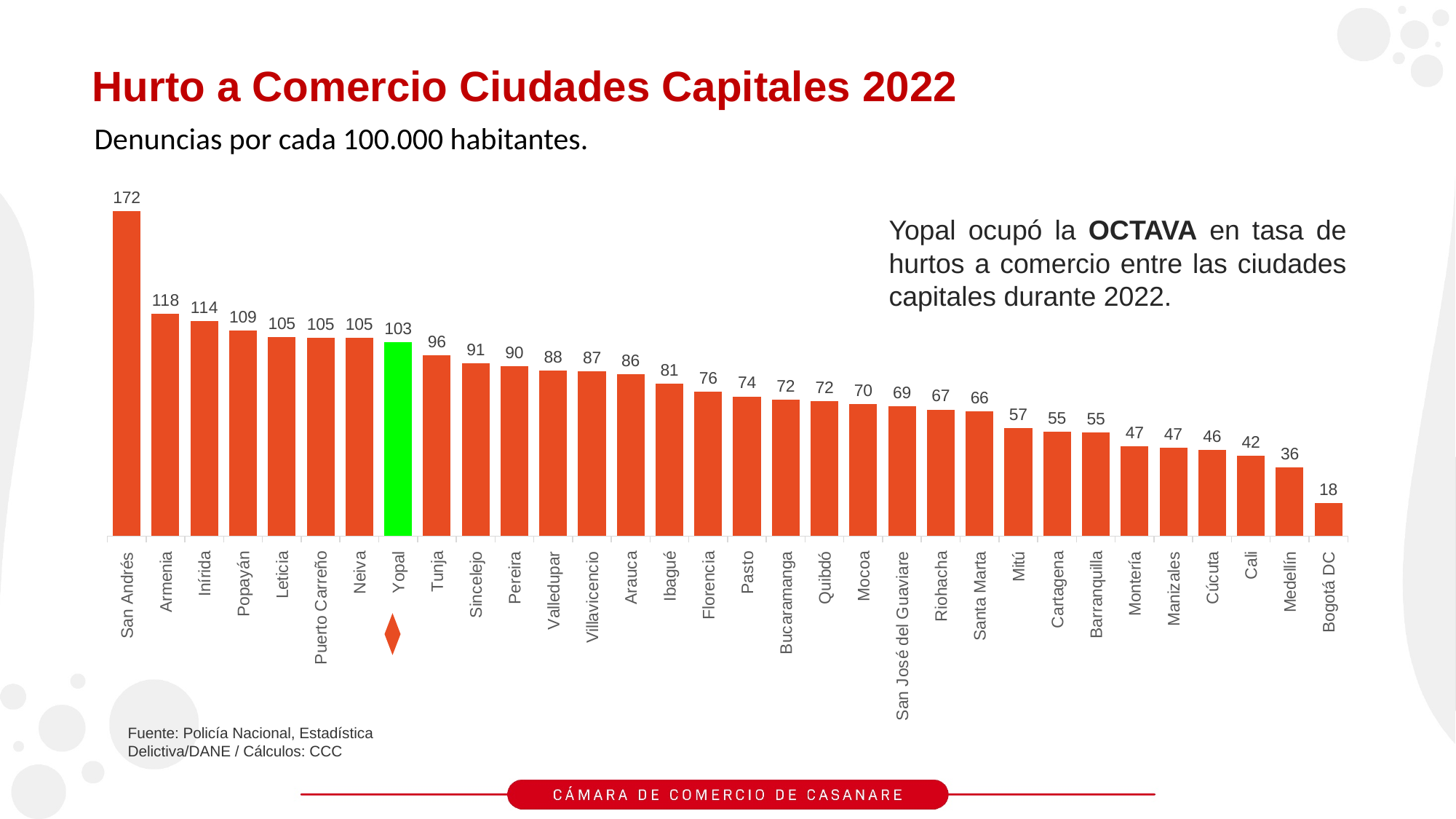
What is the value for Bucaramanga? 72 Which bar is coloured green instead of orange? Yopal Do the values rise or fall from left to right along the x axis? Fall Which city has the lowest value? Bogotá DC What kind of chart is shown on the slide? Bar chart What is the value for Yopal? 103 Which has a larger value, Tunja or Cali? Tunja How many cities are shown in the chart? 32 What is the difference between the values for San Andrés and Armenia? 54 What is the difference between the values for Yopal and Bogotá DC? 85 What is the value for Medellín? 36 Which city has the highest value? San Andrés